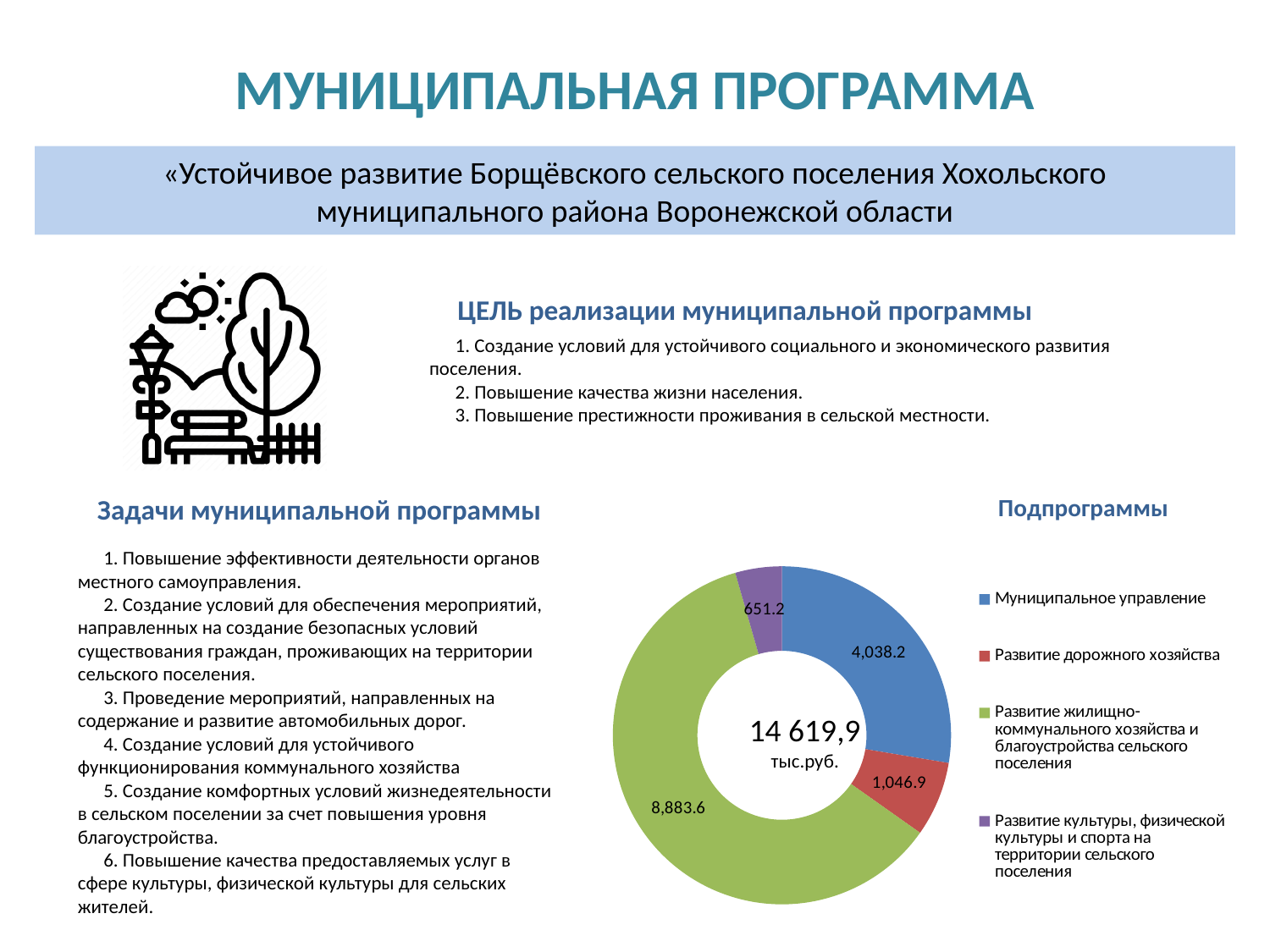
What type of chart is shown under Подпрограммы? doughnut chart Which subprogram has the largest value in the chart? Развитие жилищно-коммунального хозяйства и благоустройства сельского поселения What is the value for Развитие дорожного хозяйства in the Подпрограммы chart? 1,046.9 What is the value for Муниципальное управление in the Подпрограммы chart? 4,038.2 How many segments does the Подпрограммы chart have? 4 What total amount is shown in the centre of the chart? 14 619,9 тыс.руб. Which is larger: Муниципальное управление or Развитие дорожного хозяйства? Муниципальное управление What is the difference between the values for Развитие жилищно-коммунального хозяйства и благоустройства сельского поселения and Муниципальное управление? 4,845.4 What is the value for Развитие культуры, физической культуры и спорта на территории сельского поселения? 651.2 What is the value for Развитие жилищно-коммунального хозяйства и благоустройства сельского поселения? 8,883.6 Which subprogram has the smallest value in the chart? Развитие культуры, физической культуры и спорта на территории сельского поселения What is the difference between the values for Развитие дорожного хозяйства and Развитие культуры, физической культуры и спорта? 395.7